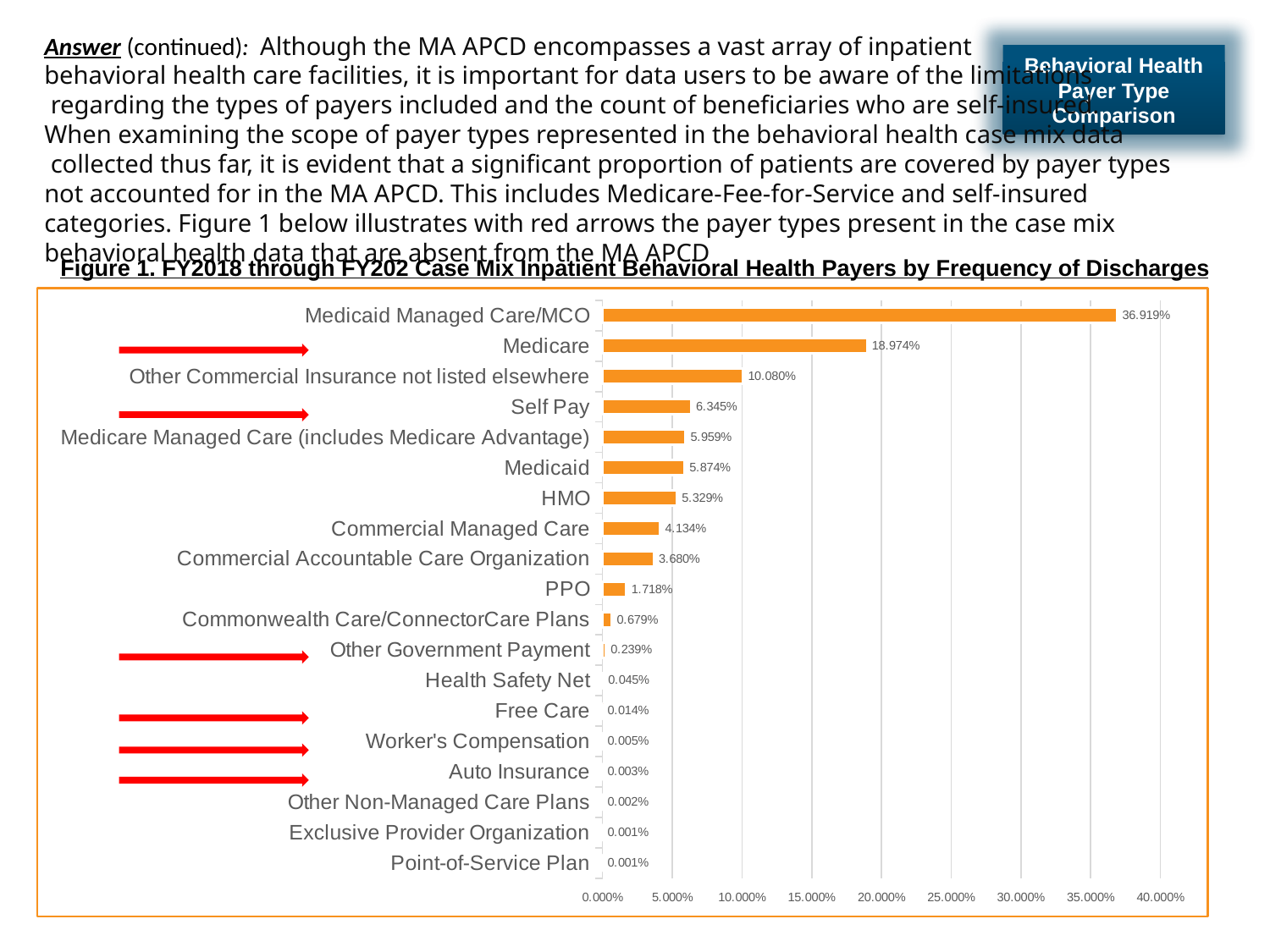
What is the difference between the values for Medicaid Managed Care/MCO and Medicare? 17.945% Which is larger, the value for HMO or the value for Commercial Managed Care? HMO How many red arrows point to payer types in the chart? 6 How many payer types are listed in the chart? 19 What is the value for Medicaid Managed Care/MCO? 36.919% Which payer type has the highest frequency of discharges? Medicaid Managed Care/MCO What is the difference between the values for Other Commercial Insurance not listed elsewhere and Self Pay? 3.735% What type of chart is shown in Figure 1? Bar chart Is the value for Medicare greater or less than 15.000%? greater What is the value for Health Safety Net? 0.045% What is the value for Commonwealth Care/ConnectorCare Plans? 0.679% What is the value for Self Pay? 6.345%